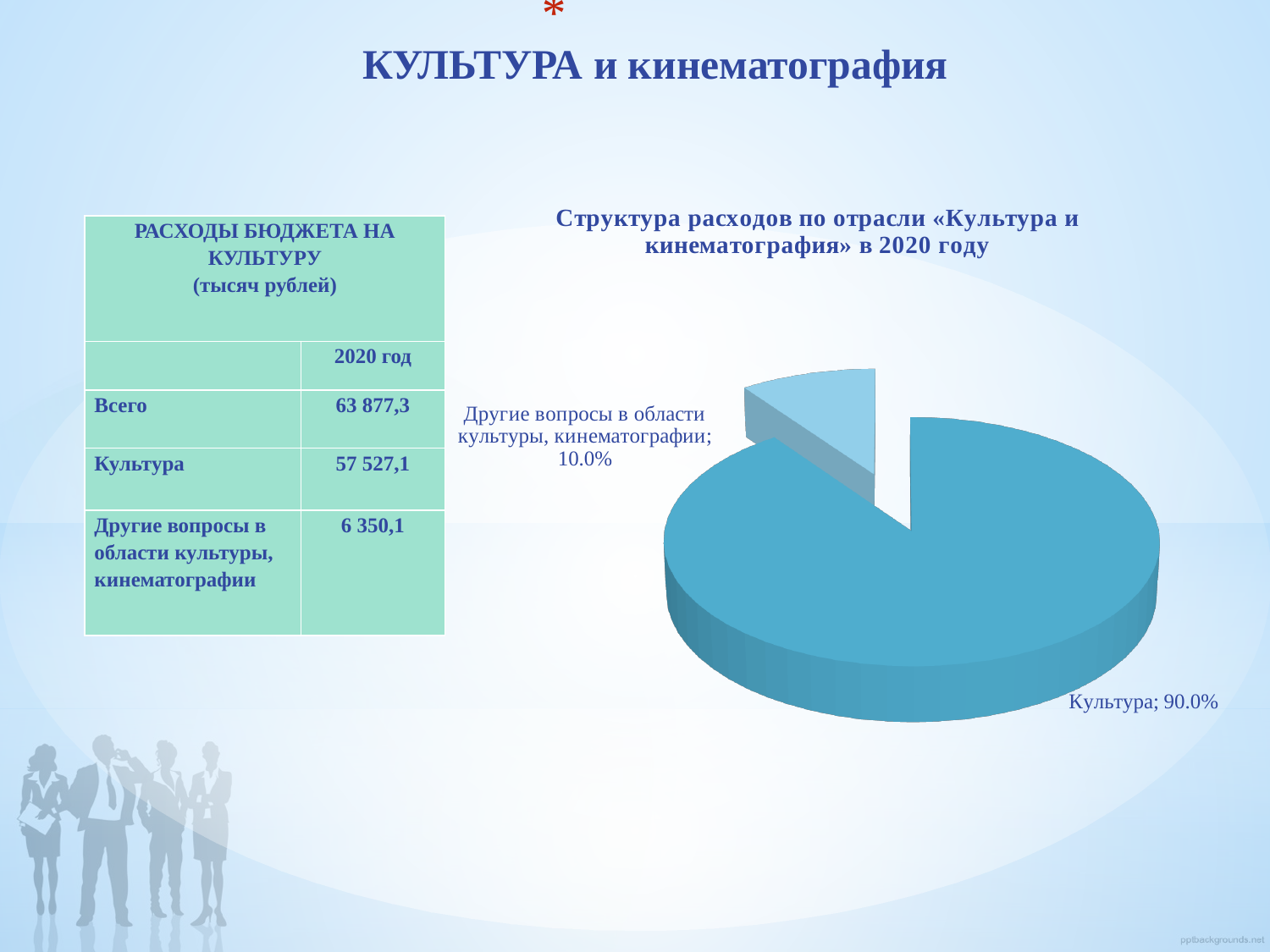
Which slice of the pie chart is the smallest? Другие вопросы в области культуры, кинематографии What share of the pie does the slice "Другие вопросы в области культуры, кинематографии" represent? 10.0% Which slice of the pie chart is the largest? Культура Which is larger: the share for "Культура" or the share for "Другие вопросы в области культуры, кинематографии"? Культура Which year does the pie chart describe? 2020 How many slices does the pie chart have? 2 What share of the pie does the slice "Культура" represent? 90.0% What is the difference in percentage points between the "Культура" slice and the "Другие вопросы в области культуры, кинематографии" slice? 80.0 percentage points What is the title of the pie chart? Структура расходов по отрасли «Культура и кинематография» в 2020 году What kind of chart is shown on the slide? Pie chart